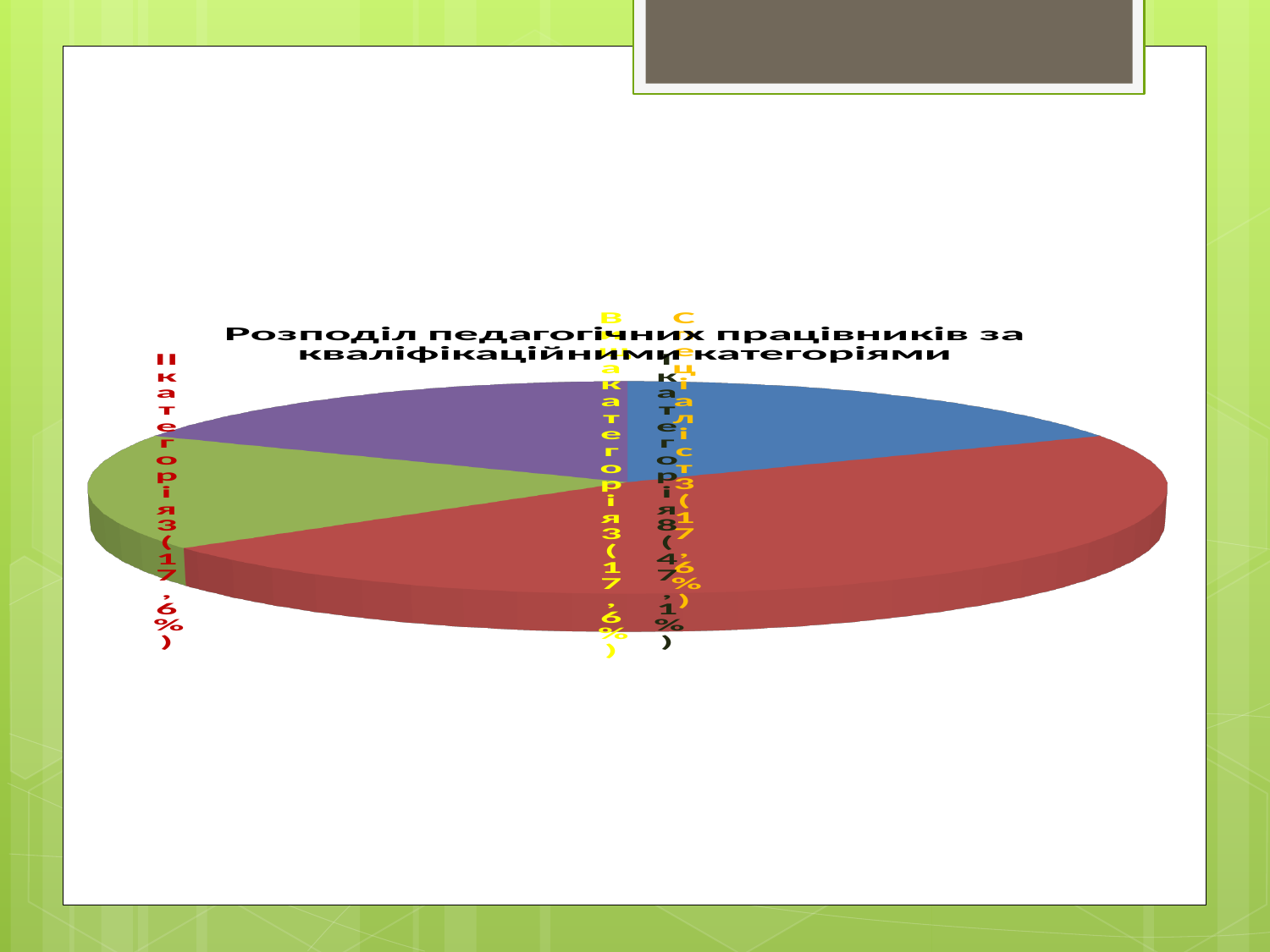
How many slices does the pie chart have? 4 What is the title of the chart? Розподіл педагогічних працівників за кваліфікаційними категоріями What kind of chart is shown on the slide? pie chart What share of the pie does І категорія have? 47,1% Which category has the largest share of the pie? І категорія How many workers are in the Спеціаліст category? 3 How many categories each have a share of 17,6%? 3 What share of the pie does ІІ категорія have? 17,6% Which is larger, the share for І категорія or the share for Вища категорія? І категорія What is the difference in percentage points between the share of І категорія and the share of ІІ категорія? 29,5% How many workers are in І категорія? 8 What colour is the largest slice of the pie? red